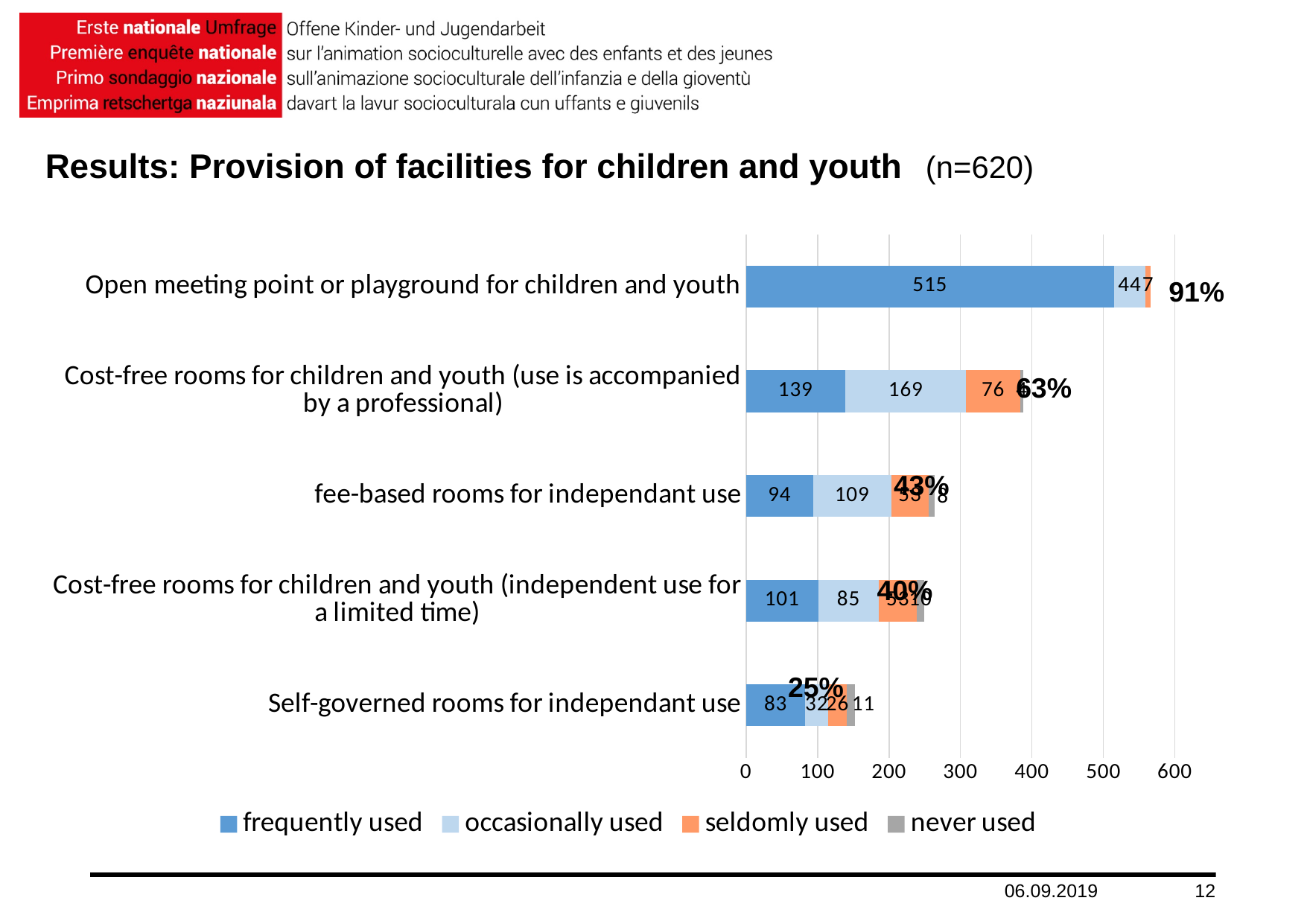
What kind of chart is shown on the slide? bar chart What is the 'frequently used' value for 'Open meeting point or playground for children and youth'? 515 Which has the larger 'occasionally used' value: 'fee-based rooms for independant use' or 'Cost-free rooms for children and youth (independent use for a limited time)'? fee-based rooms for independant use What is the 'occasionally used' value for 'Cost-free rooms for children and youth (use is accompanied by a professional)'? 169 What is the 'frequently used' value for 'Self-governed rooms for independant use'? 83 What is the 'seldomly used' value for 'Cost-free rooms for children and youth (use is accompanied by a professional)'? 76 Is the total bar length for 'Open meeting point or playground for children and youth' greater or less than 500? greater Which category has the highest 'frequently used' value? Open meeting point or playground for children and youth Which category has the lowest 'frequently used' value? Self-governed rooms for independant use How many categories (facility types) does the chart show? 5 How many series does the legend list? 4 What is the difference between the 'frequently used' values for 'Open meeting point or playground for children and youth' and 'Cost-free rooms for children and youth (use is accompanied by a professional)'? 376